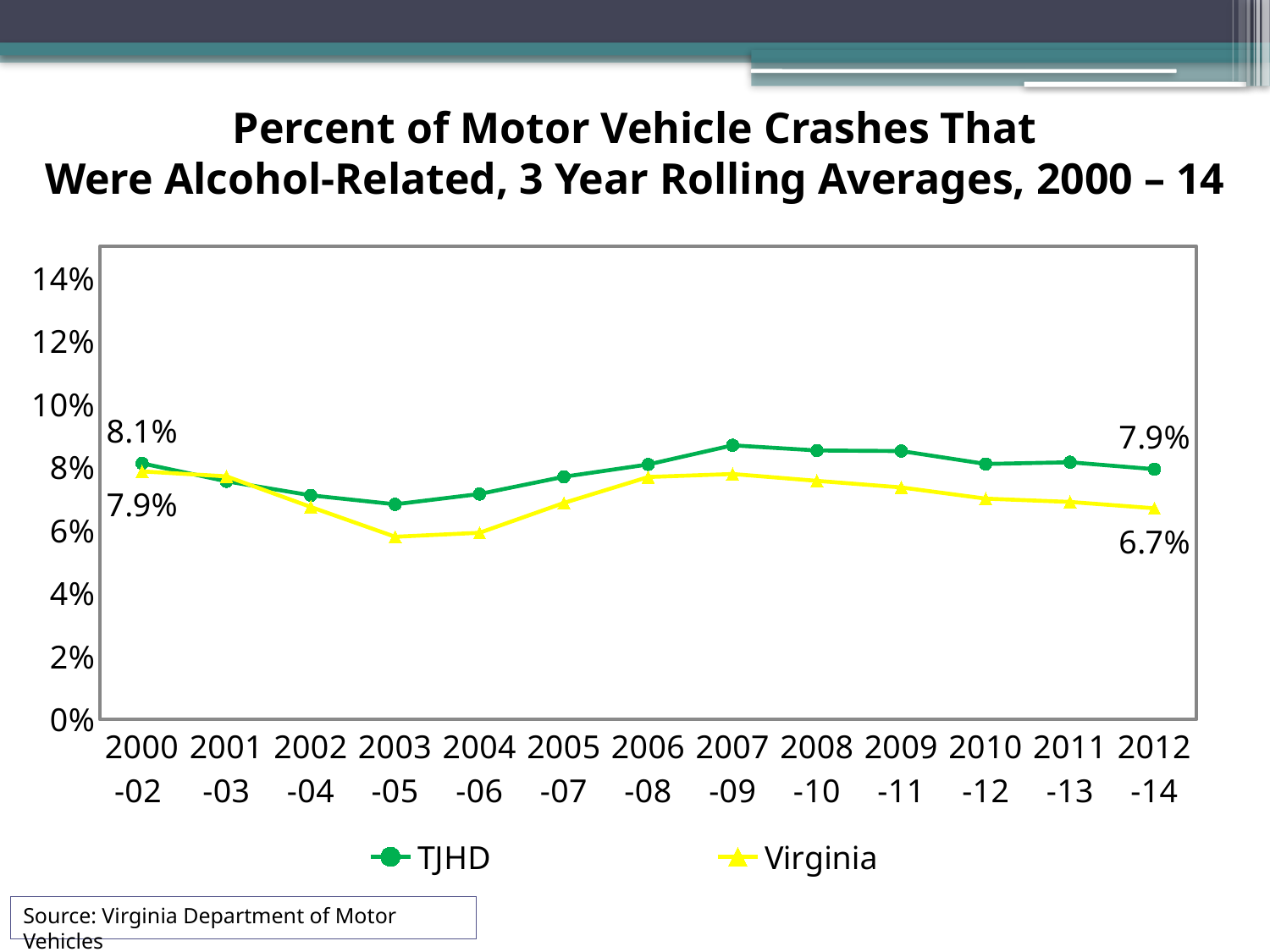
What is the Virginia value for 2000-02? 7.9% Is the Virginia value for 2003-05 greater or less than 8%? less What is the Virginia value for 2012-14? 6.7% How many series does the legend list? 2 What is the TJHD value for 2000-02? 8.1% In 2012-14, which series has the higher value, TJHD or Virginia? TJHD By how many percentage points did the TJHD value change from 2000-02 to 2012-14? 0.2 percentage points What is the difference between the TJHD and Virginia values in 2012-14? 1.2 percentage points What kind of chart is shown on the slide? Line chart In which period does the TJHD series reach its highest value? 2007-09 How many time periods are plotted on the x axis? 13 What is the TJHD value for 2012-14? 7.9%